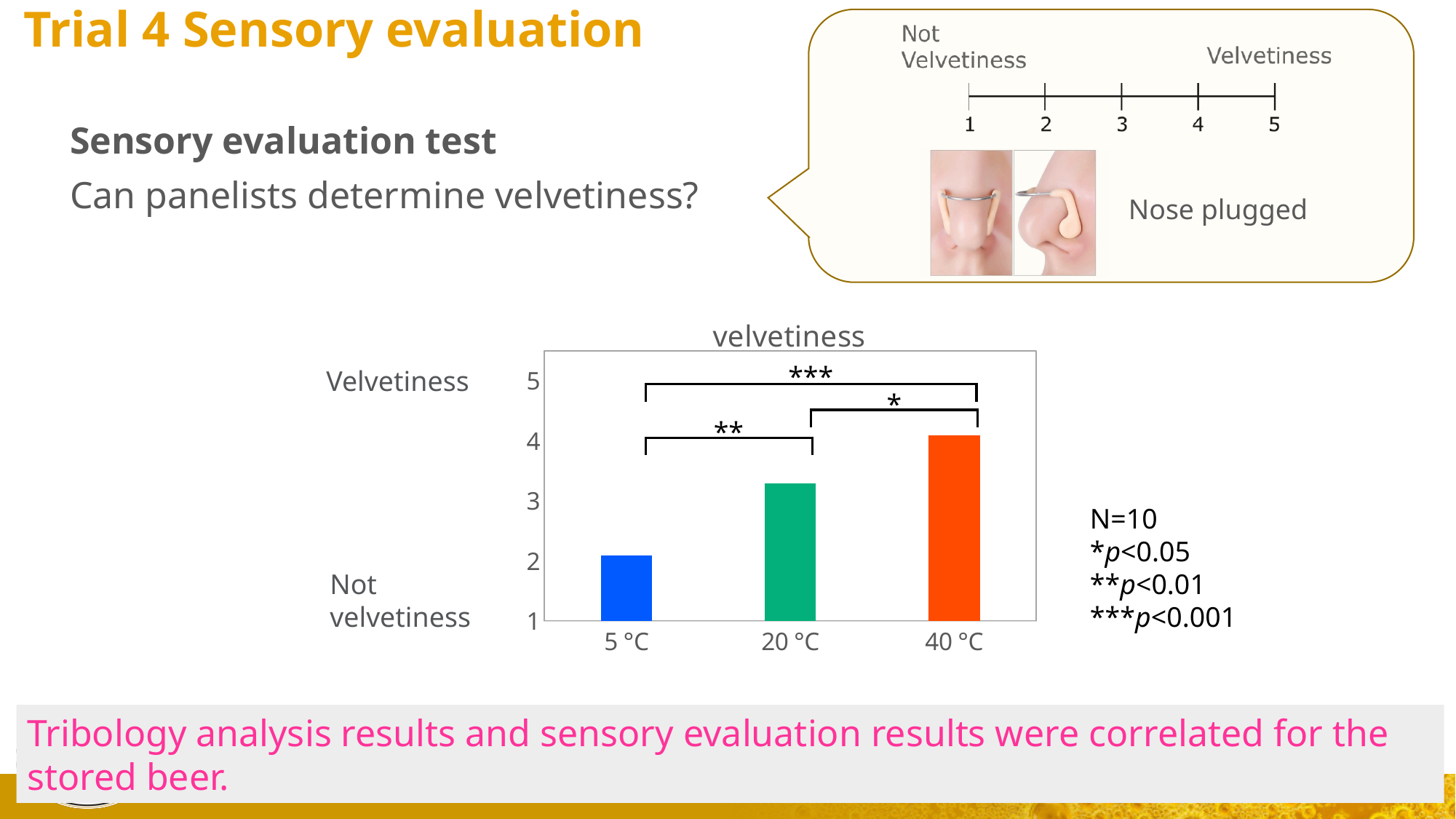
Do the velvetiness scores rise or fall as the temperature increases from 5 °C to 40 °C? rise Is the velvetiness score for 20 °C greater or less than 4? less Which has a higher velvetiness score, 5 °C or 20 °C? 20 °C Which temperature has the highest velvetiness score? 40 °C What colour is the bar for 5 °C? blue What kind of chart is shown on the slide? bar chart Is the velvetiness score for 20 °C greater or less than 3? greater How many temperature categories are plotted in the chart? 3 Is the velvetiness score for 40 °C greater or less than 3? greater Which temperature has the lowest velvetiness score? 5 °C What is the title of the chart? velvetiness